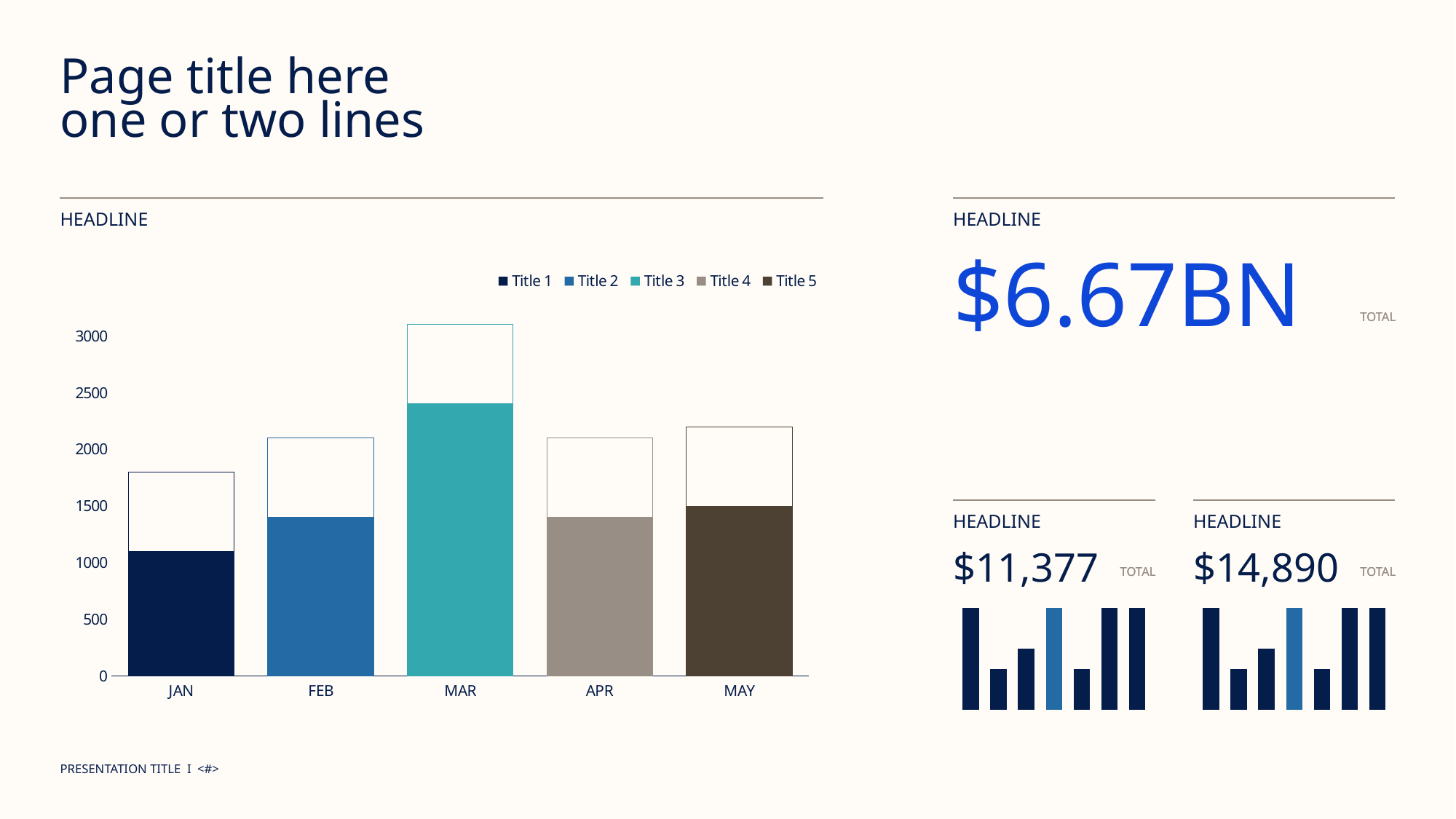
In the large bar chart on the left, which month has the tallest filled bar? MAR In the large bar chart on the left, is the filled bar for MAR greater or less than 2000? greater In the large bar chart on the left, is the filled bar for JAN greater or less than 1500? less In the large bar chart on the left, how many categories are shown on the x axis? 5 In the large bar chart on the left, is the filled bar for MAY greater or less than 1000? greater In the large bar chart on the left, which filled bar is taller, MAR or JAN? MAR In the small bar chart below the $11,377 figure, how many bars are there? 7 In the large bar chart on the left, which month has the shortest filled bar? JAN In the large bar chart on the left, what are the legend entries? Title 1, Title 2, Title 3, Title 4, Title 5 What kind of chart is the large chart on the left of the slide? bar chart In the large bar chart on the left, how many series does the legend list? 5